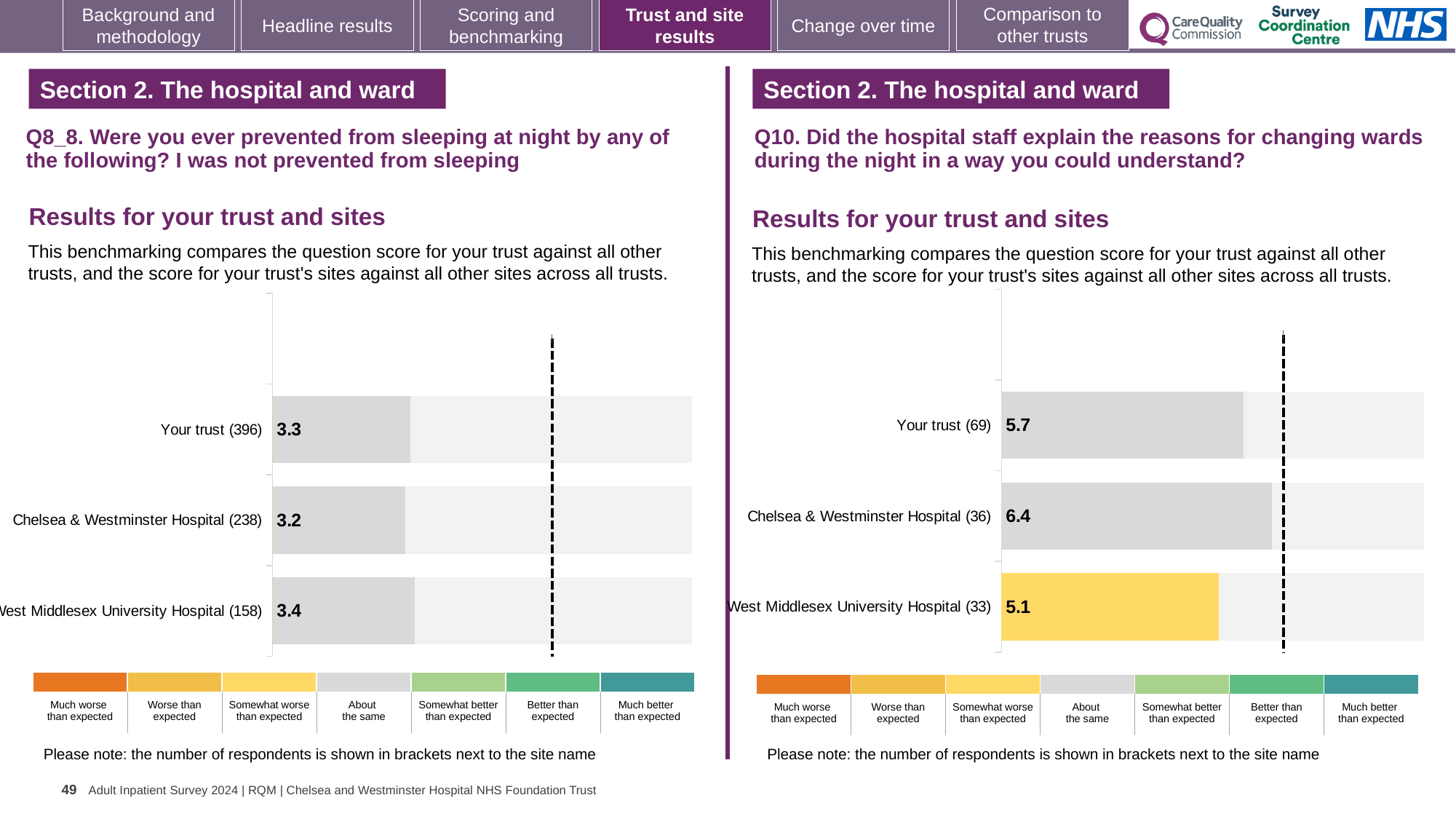
In the right chart (Q10), which site or trust has the lowest score? West Middlesex University Hospital (33) How many bars are plotted in the left chart (Q8_8)? 3 In the right chart (Q10), what is the score for Chelsea & Westminster Hospital (36)? 6.4 In the left chart (Q8_8), what is the score for Your trust (396)? 3.3 In the left chart (Q8_8), what is the score for West Middlesex University Hospital (158)? 3.4 What type of chart is used on the right side of the slide (Q10)? Bar chart In the right chart (Q10), which site or trust has the highest score? Chelsea & Westminster Hospital (36) In the right chart (Q10), what is the score for Your trust (69)? 5.7 In the left chart (Q8_8), which site or trust has the lowest score? Chelsea & Westminster Hospital (238) In the right chart (Q10), which has the larger score: Your trust or West Middlesex University Hospital? Your trust In the left chart (Q8_8), what is the difference between the scores for West Middlesex University Hospital and Chelsea & Westminster Hospital? 0.2 In the right chart (Q10), what is the difference between the scores for Chelsea & Westminster Hospital and West Middlesex University Hospital? 1.3